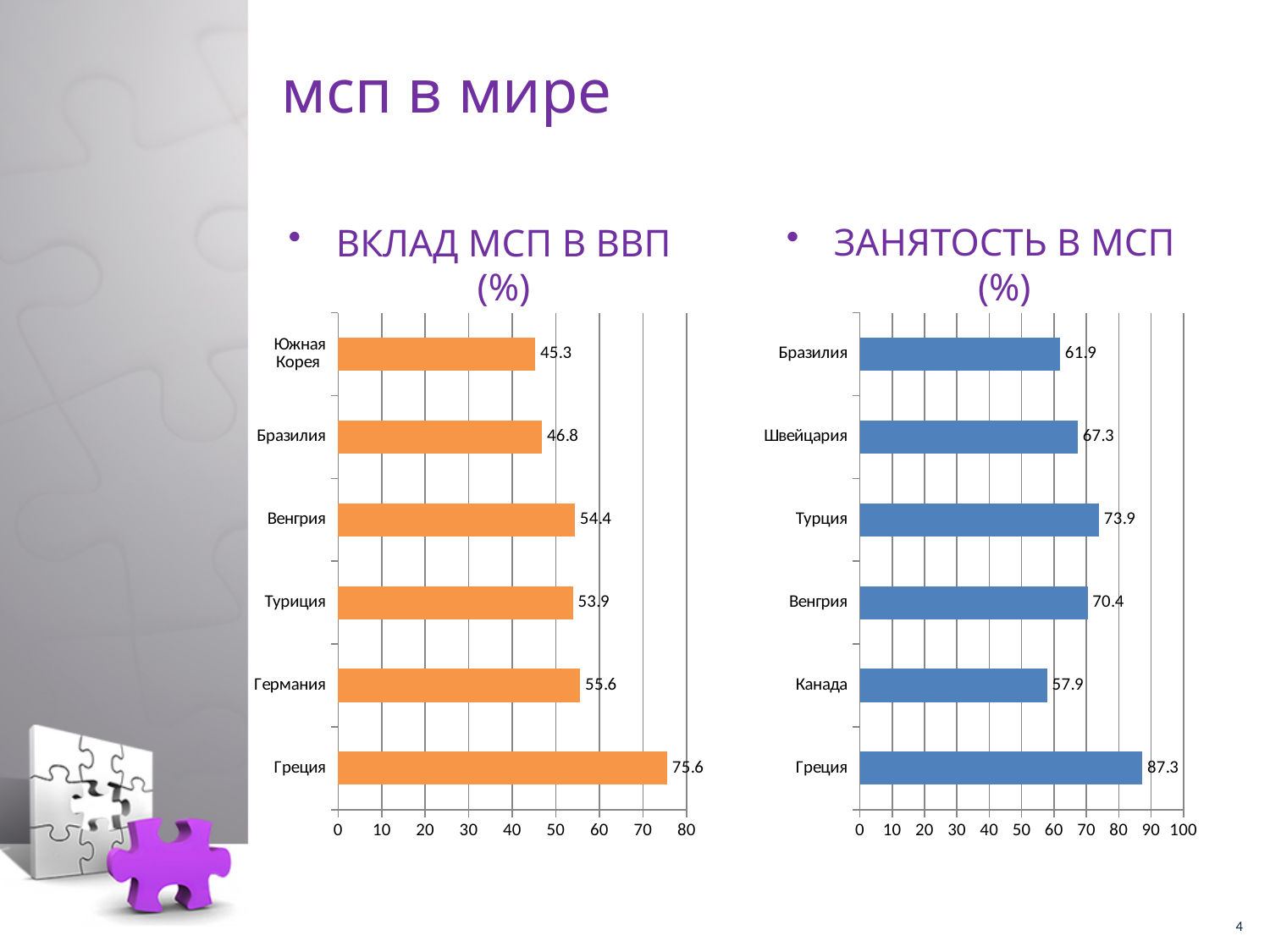
In the chart titled "ВКЛАД МСП В ВВП (%)", what is the value for Южная Корея? 45.3 In the chart titled "ВКЛАД МСП В ВВП (%)", how many countries are shown? 6 In the chart titled "ЗАНЯТОСТЬ В МСП (%)", which is larger, the value for Швейцария or the value for Бразилия? Швейцария In the chart titled "ЗАНЯТОСТЬ В МСП (%)", what is the difference between the values for Греция and Канада? 29.4 In the chart titled "ЗАНЯТОСТЬ В МСП (%)", what is the value for Турция? 73.9 What kind of chart is the chart titled "ЗАНЯТОСТЬ В МСП (%)"? bar chart What colour are the bars in the chart titled "ВКЛАД МСП В ВВП (%)"? orange In the chart titled "ВКЛАД МСП В ВВП (%)", what is the value for Греция? 75.6 In the chart titled "ЗАНЯТОСТЬ В МСП (%)", which country has the highest value? Греция In the chart titled "ЗАНЯТОСТЬ В МСП (%)", which country has the lowest value? Канада In the chart titled "ВКЛАД МСП В ВВП (%)", what is the difference between the values for Германия and Бразилия? 8.8 In the chart titled "ВКЛАД МСП В ВВП (%)", which country has the lowest value? Южная Корея